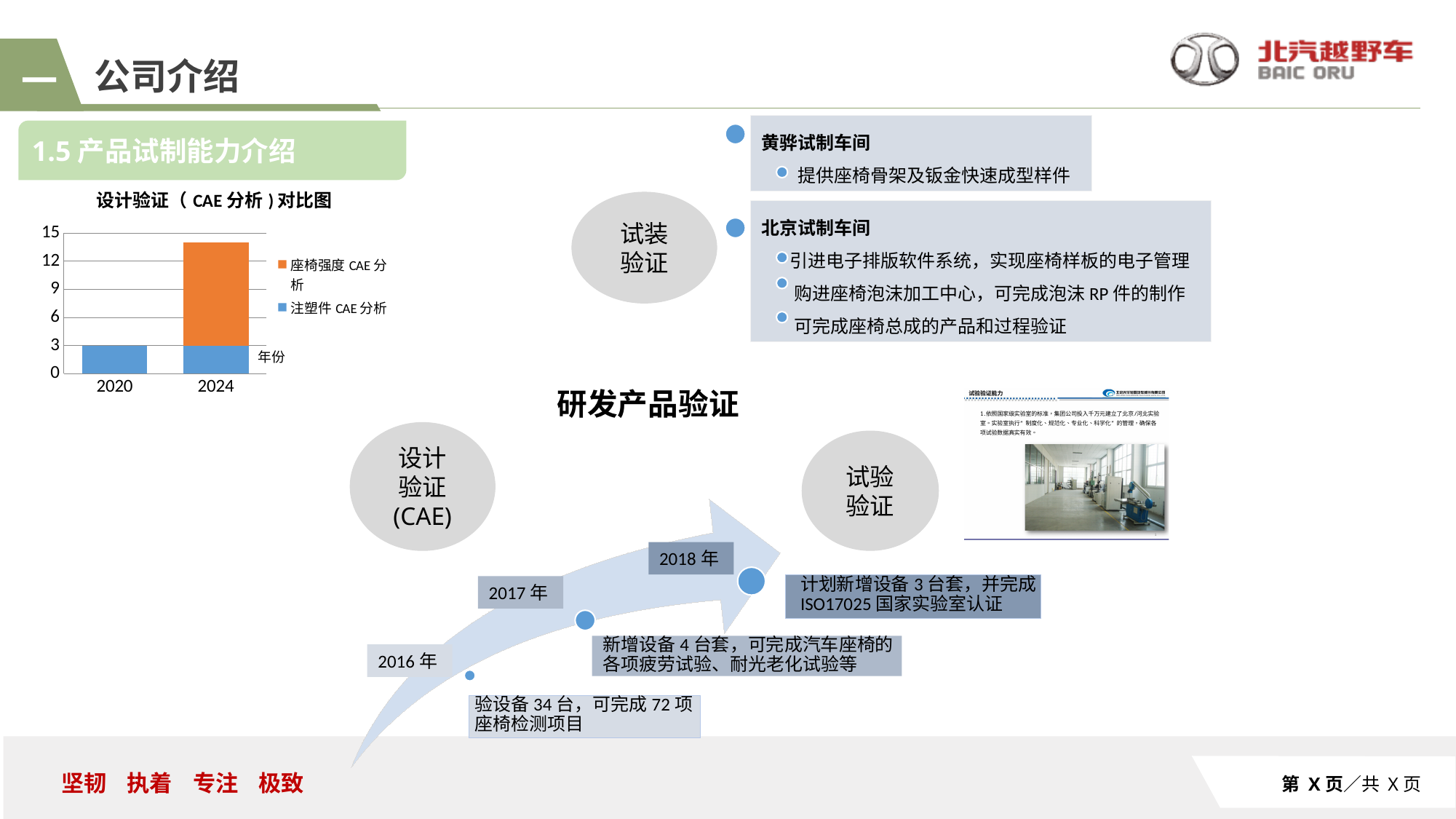
What is the value of 注塑件 CAE 分析 for 2020? 3 Is the total stacked value for 2024 greater or less than 12? greater What is the title of the chart? 设计验证（CAE分析）对比图 Is the 座椅强度 CAE 分析 value for 2024 greater or less than 9? greater Do the total values rise or fall from 2020 to 2024? rise How many series does the chart legend list? 2 Is the total value for 2020 greater or less than 6? less Which series is shown in orange in the chart? 座椅强度 CAE 分析 Which year has the higher total stacked value, 2020 or 2024? 2024 Which year has the highest total in the chart? 2024 What kind of chart is shown on the slide? bar chart How many year categories are shown on the x axis of the chart? 2